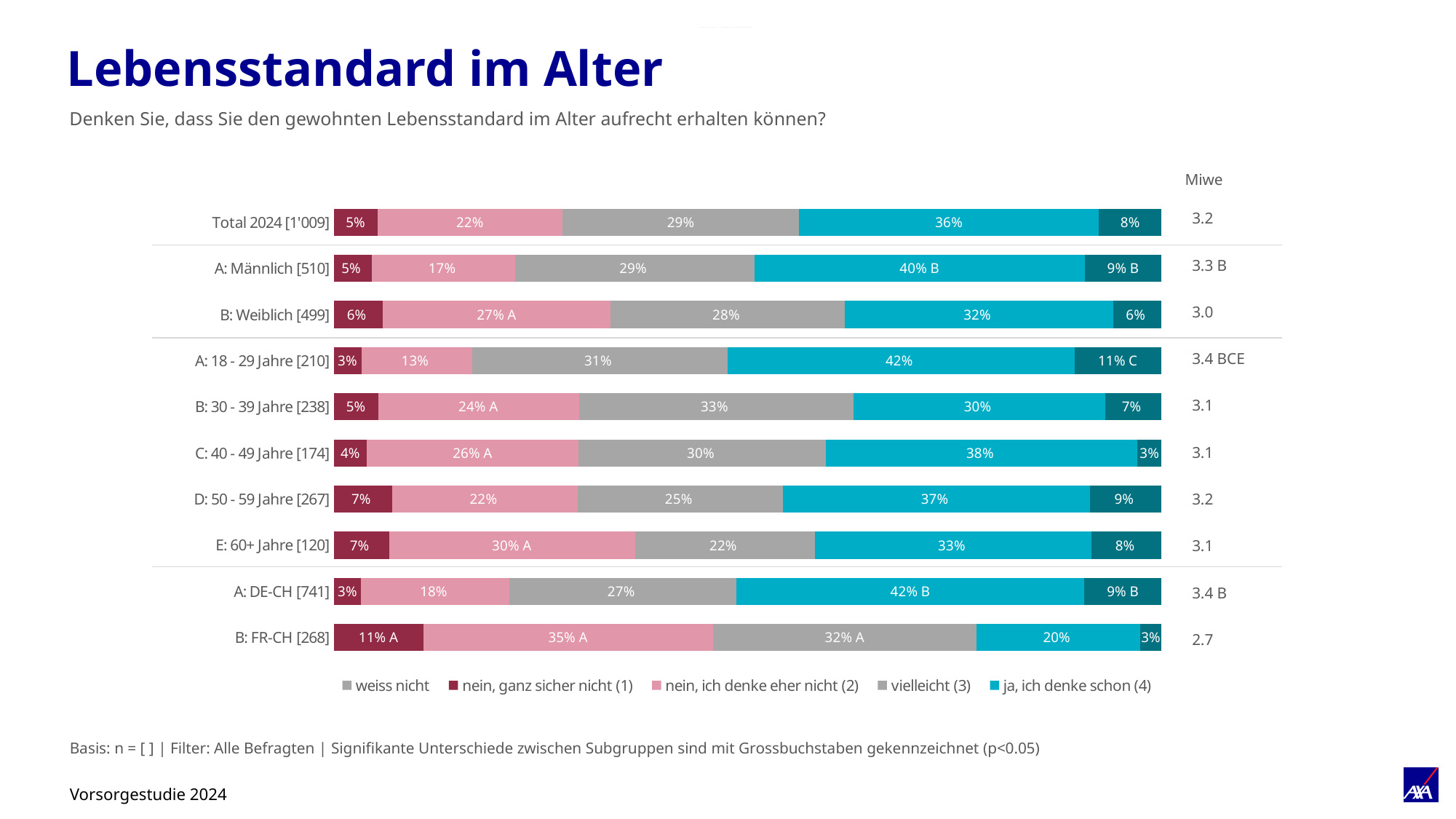
Which category has the lowest value for "ja, ich denke schon (4)"? B: FR-CH [268] Which has a larger value for "ja, ich denke schon (4)": A: Männlich [510] or B: Weiblich [499]? A: Männlich [510] What is the value of "nein, ich denke eher nicht (2)" for Total 2024 [1'009]? 22% What is the Miwe value shown for Total 2024 [1'009]? 3.2 Which category has the lowest Miwe value? B: FR-CH [268] Which category has the highest value for "nein, ganz sicher nicht (1)"? B: FR-CH [268] How many series does the legend list? 5 For Total 2024 [1'009], what is the difference between "vielleicht (3)" and "nein, ich denke eher nicht (2)"? 7 percentage points What kind of chart is shown on the slide? Stacked bar chart What is the value of "vielleicht (3)" for D: 50 - 59 Jahre [267]? 25% What is the value of "ja, ich denke schon (4)" for Total 2024 [1'009]? 36% How many categories (bars) are shown in the chart? 10